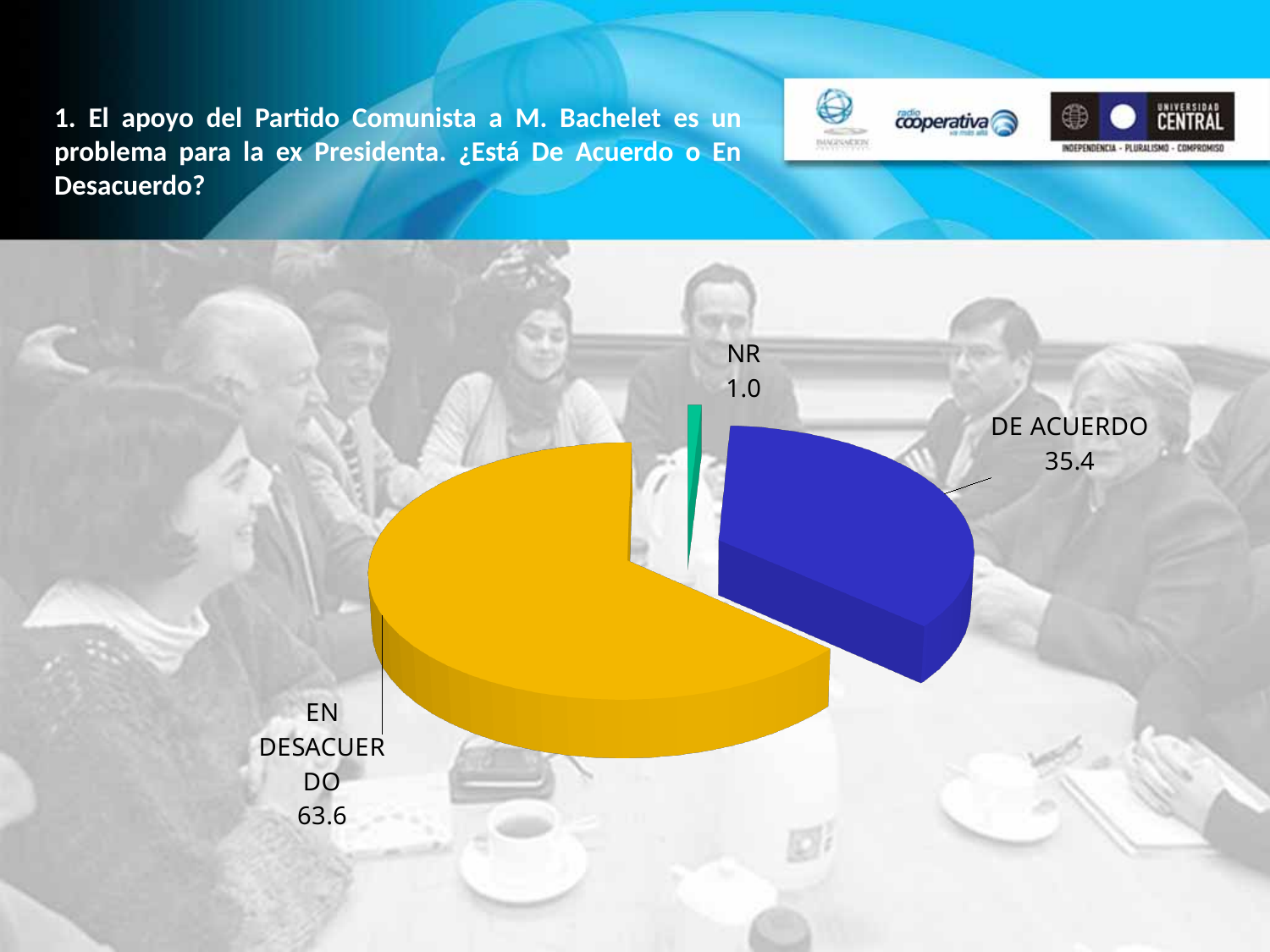
What is the total of the three slice values? 100.0 What is the difference between the values for EN DESACUERDO and DE ACUERDO? 28.2 Which category has the smallest slice? NR What colour is the DE ACUERDO slice? Blue What is the value for EN DESACUERDO? 63.6 Which is larger, DE ACUERDO or NR? DE ACUERDO What kind of chart is shown on the slide? Pie chart What is the value for NR? 1.0 What is the value for DE ACUERDO? 35.4 What colour is the EN DESACUERDO slice? Yellow How many slices does the pie chart have? 3 Which category has the largest slice? EN DESACUERDO